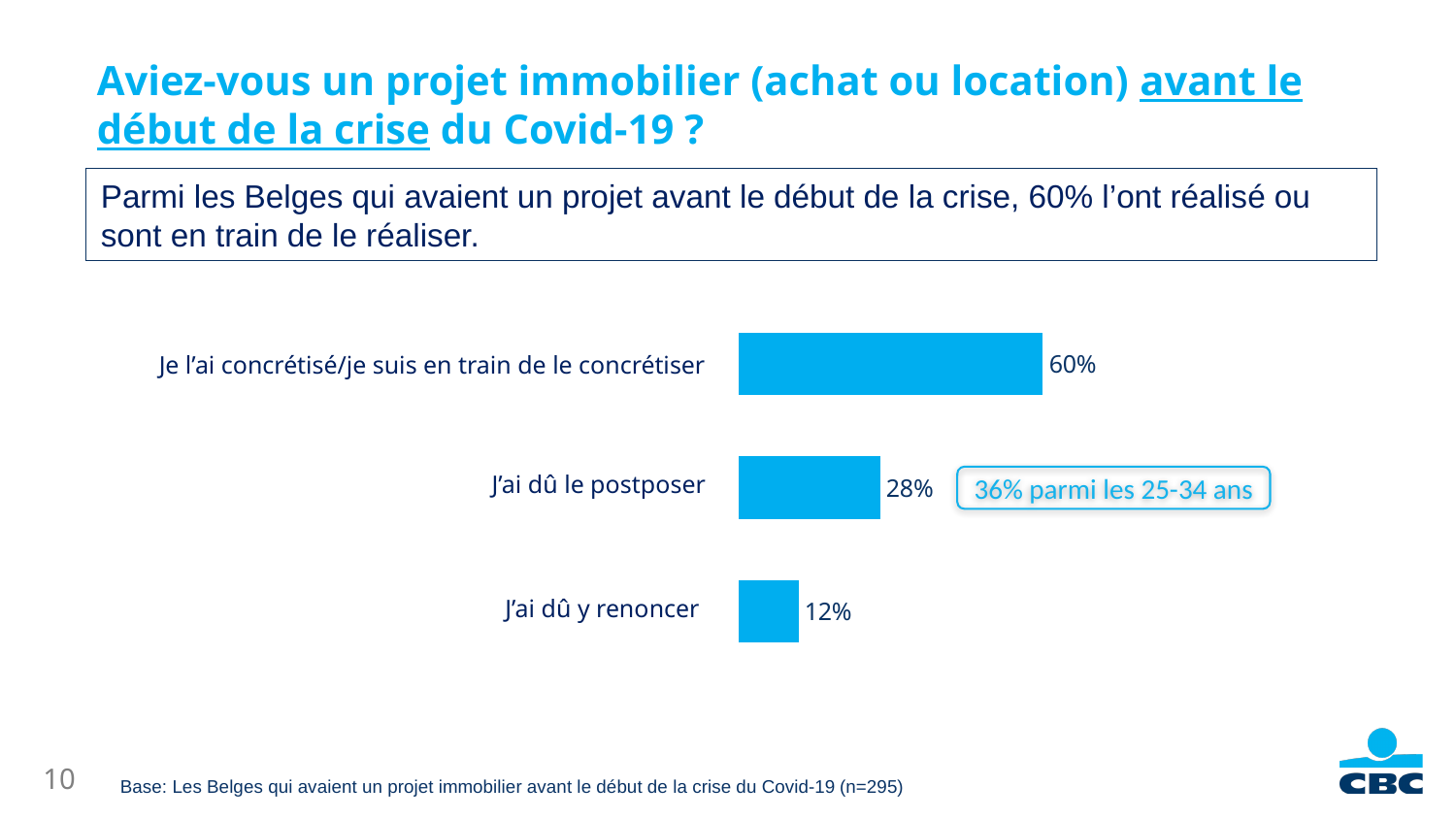
What is the difference between the values for "J'ai dû le postposer" and "J'ai dû y renoncer"? 16% What is the difference between the values for "Je l'ai concrétisé/je suis en train de le concrétiser" and "J'ai dû le postposer"? 32% According to the callout next to "J'ai dû le postposer", what is the value among 25-34 year olds? 36% Which category has the lowest value? J'ai dû y renoncer What is the sample size (n) given in the base note below the chart? 295 Which category has the highest value? Je l'ai concrétisé/je suis en train de le concrétiser Which is larger: the value for "J'ai dû le postposer" or "J'ai dû y renoncer"? J'ai dû le postposer How many categories are shown in the chart? 3 What is the value for "J'ai dû le postposer"? 28% What is the value for "Je l'ai concrétisé/je suis en train de le concrétiser"? 60% What is the value for "J'ai dû y renoncer"? 12% What kind of chart is shown on the slide? Bar chart